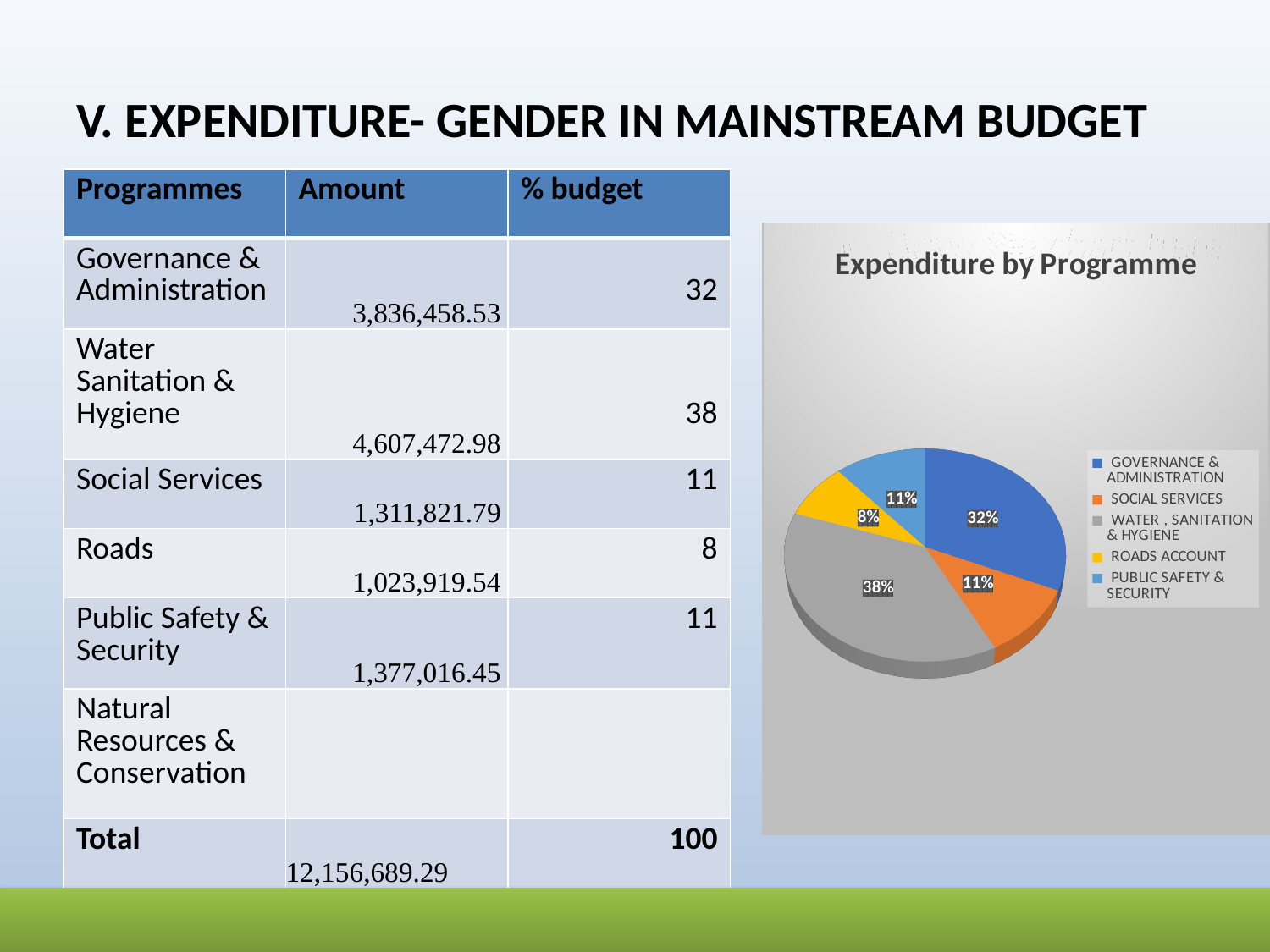
What share of the pie does Social Services represent? 11% What share of the pie does Water, Sanitation & Hygiene represent? 38% Which programme has the largest slice of the pie? Water, Sanitation & Hygiene What share of the pie does Roads Account represent? 8% What is the difference in percentage points between the Water, Sanitation & Hygiene slice and the Governance & Administration slice? 6 How many entries does the legend list? 5 Which programme has the smallest slice of the pie? Roads Account What type of chart is shown on the slide? pie chart What is the title of the chart? Expenditure by Programme Which is larger, the Governance & Administration slice or the Social Services slice? Governance & Administration How many slices does the pie chart have? 5